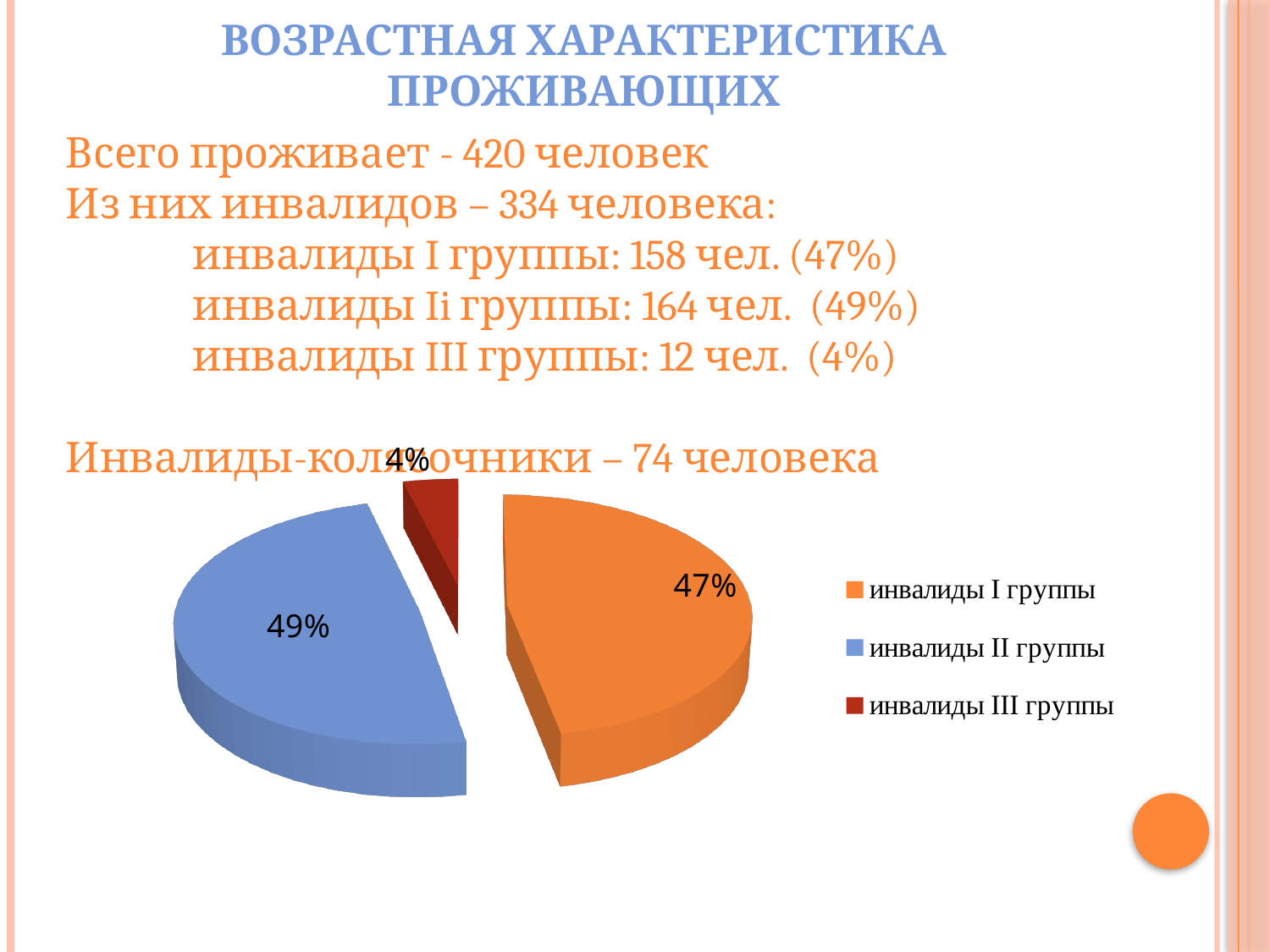
What share of the pie does инвалиды II группы have? 49% What share of the pie does инвалиды III группы have? 4% Which colour represents инвалиды II группы in the pie chart? blue Which group has the smallest slice of the pie? инвалиды III группы What share of the pie does инвалиды I группы have? 47% How many slices does the pie chart have? 3 Which colour represents инвалиды III группы in the pie chart? dark red What is the difference in percentage points between the slices for инвалиды I группы and инвалиды III группы? 43% What is the difference in percentage points between the slices for инвалиды II группы and инвалиды I группы? 2% What kind of chart is shown on the slide? pie chart Which group has the largest slice of the pie? инвалиды II группы How many entries does the legend list? 3